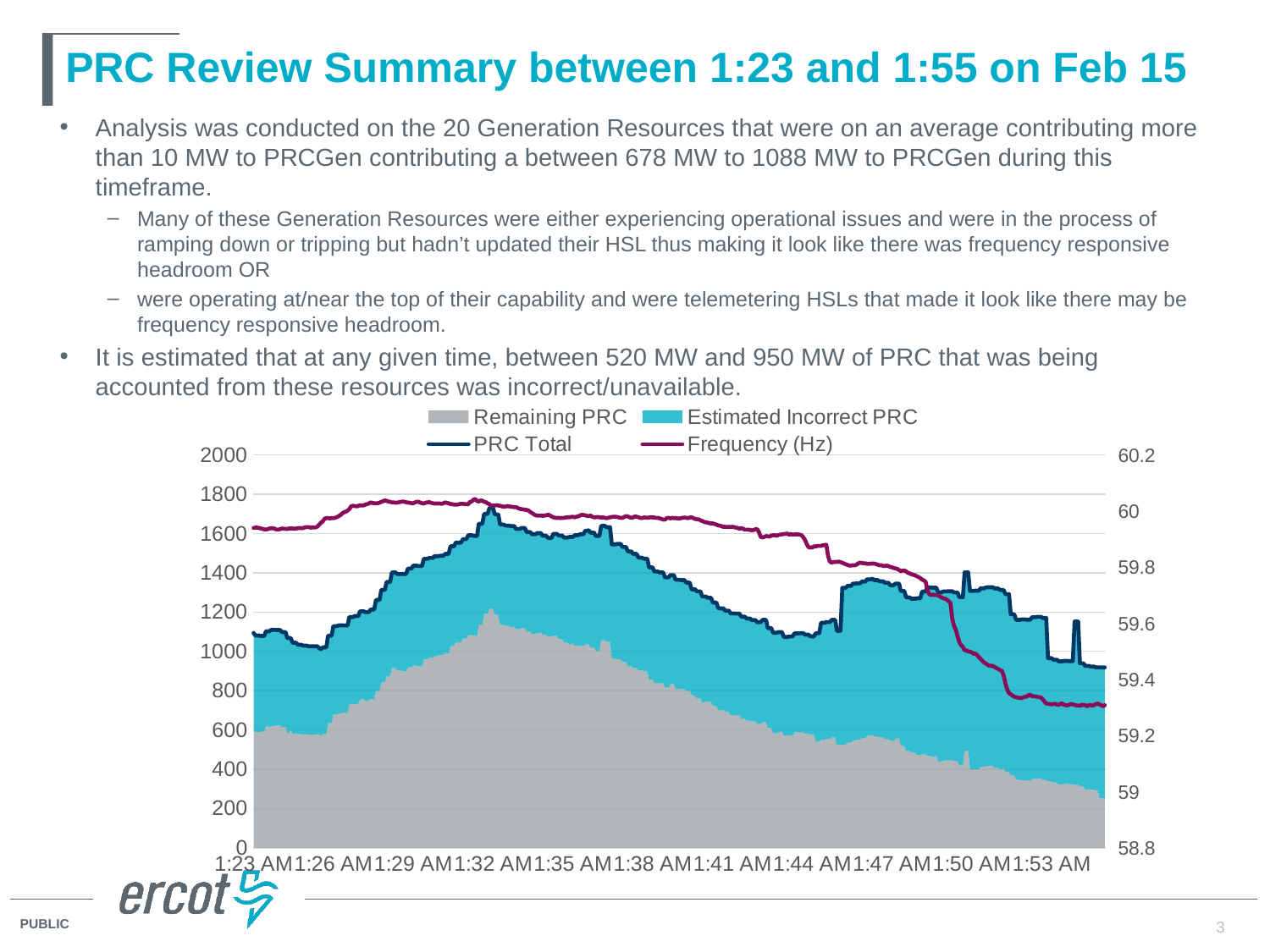
Is the Frequency (Hz) value at 1:32 AM greater or less than 59.8? greater How many time labels are shown along the x axis? 11 How many series does the chart legend list? 4 Is the Frequency (Hz) value at 1:53 AM greater or less than 59.4? less Is the PRC Total value at 1:23 AM greater or less than 1000? greater What kind of chart is shown on the slide? Combination stacked area and line chart What is the maximum value shown on the left vertical axis? 2000 Which series is plotted against the right-hand axis (58.8 to 60.2)? Frequency (Hz) Does the Frequency (Hz) line rise or fall overall from 1:23 AM to the end of the chart? Fall Which is larger, the Frequency (Hz) value at 1:23 AM or at 1:53 AM? 1:23 AM